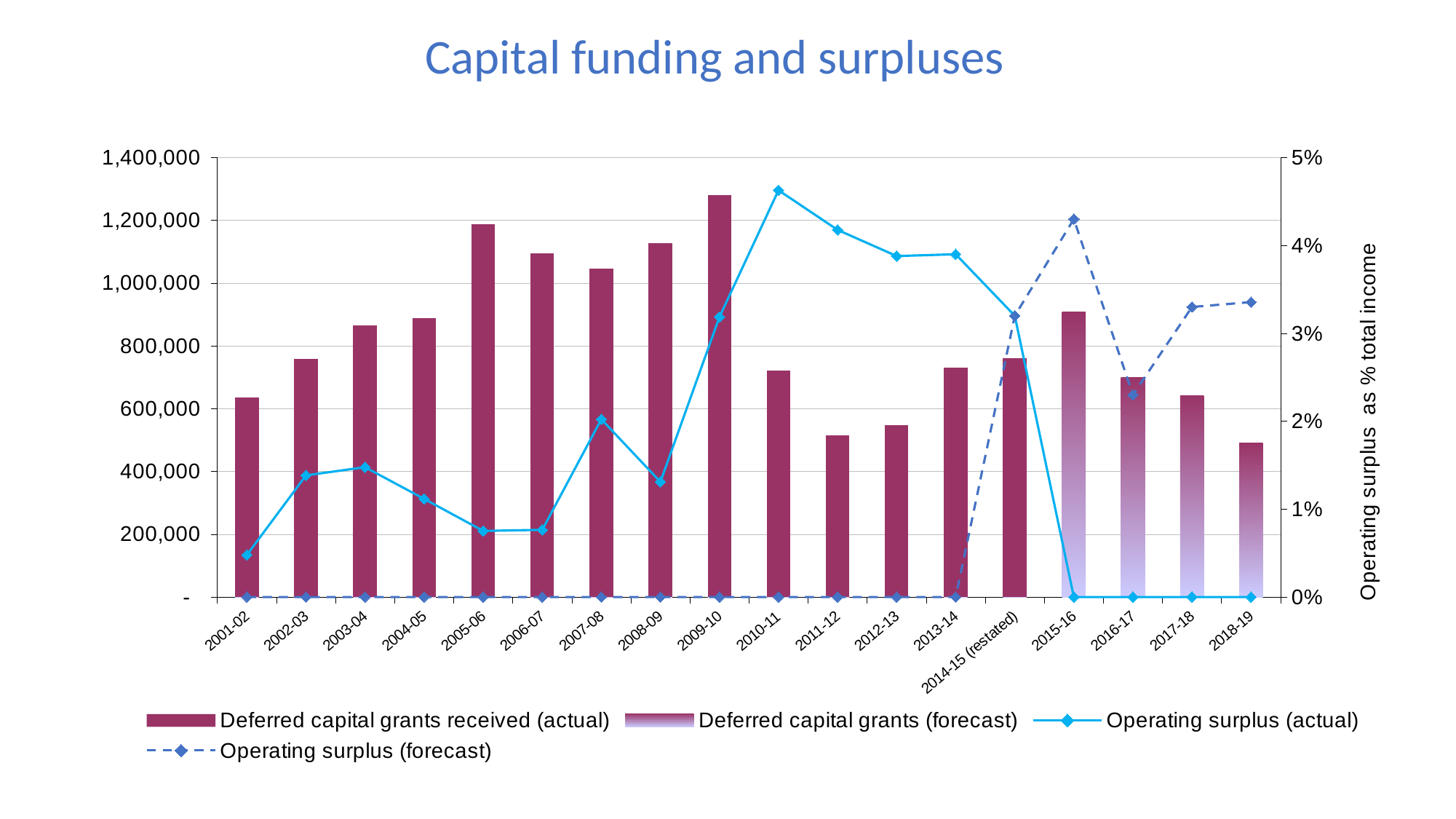
In which year does the operating surplus (actual) line reach its highest point? 2010-11 What kind of chart is this? Combination bar and line chart In which year is the deferred capital grants bar the highest? 2009-10 How many categories are shown on the x axis? 18 Is the operating surplus (actual) for 2010-11 greater or less than 4%? greater Is the operating surplus (forecast) for 2016-17 greater or less than 3%? less What is the title of the chart? Capital funding and surpluses Does the operating surplus (actual) line rise or fall from 2010-11 to 2013-14? fall How many series does the legend list? 4 Is the deferred capital grants received (actual) value for 2005-06 greater or less than 1,000,000? greater Which year has the larger deferred capital grants received (actual) bar, 2004-05 or 2005-06? 2005-06